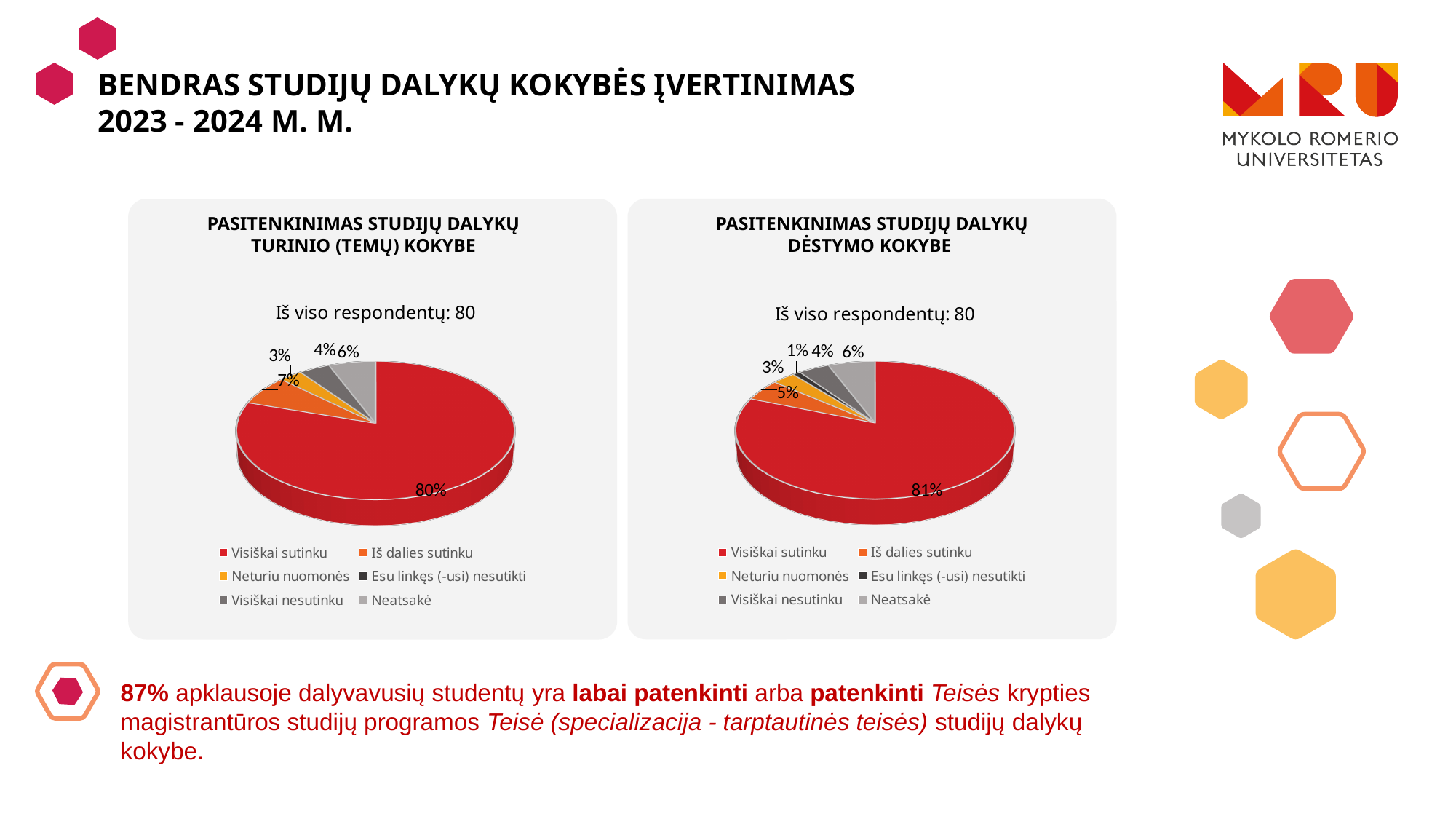
What is the difference between the 'Visiškai sutinku' share in the right chart and in the left chart? 1% In the right chart, what share of respondents answered 'Neatsakė'? 6% How many entries does the legend of the left chart list? 6 What type of chart is used on this slide? Pie chart In the chart titled 'PASITENKINIMAS STUDIJŲ DALYKŲ TURINIO (TEMŲ) KOKYBE', what share of respondents answered 'Visiškai sutinku'? 80% In the right chart, what is the smallest slice value shown? 1% How many respondents in total are reported for the right chart? 80 In the chart titled 'PASITENKINIMAS STUDIJŲ DALYKŲ DĖSTYMO KOKYBE', what share of respondents answered 'Visiškai sutinku'? 81% In the left chart, what share of respondents answered 'Iš dalies sutinku'? 7% Which category has the largest slice in the left chart? Visiškai sutinku Which chart has the larger 'Iš dalies sutinku' share, the left chart or the right chart? The left chart In the right chart, what share of respondents answered 'Iš dalies sutinku'? 5%